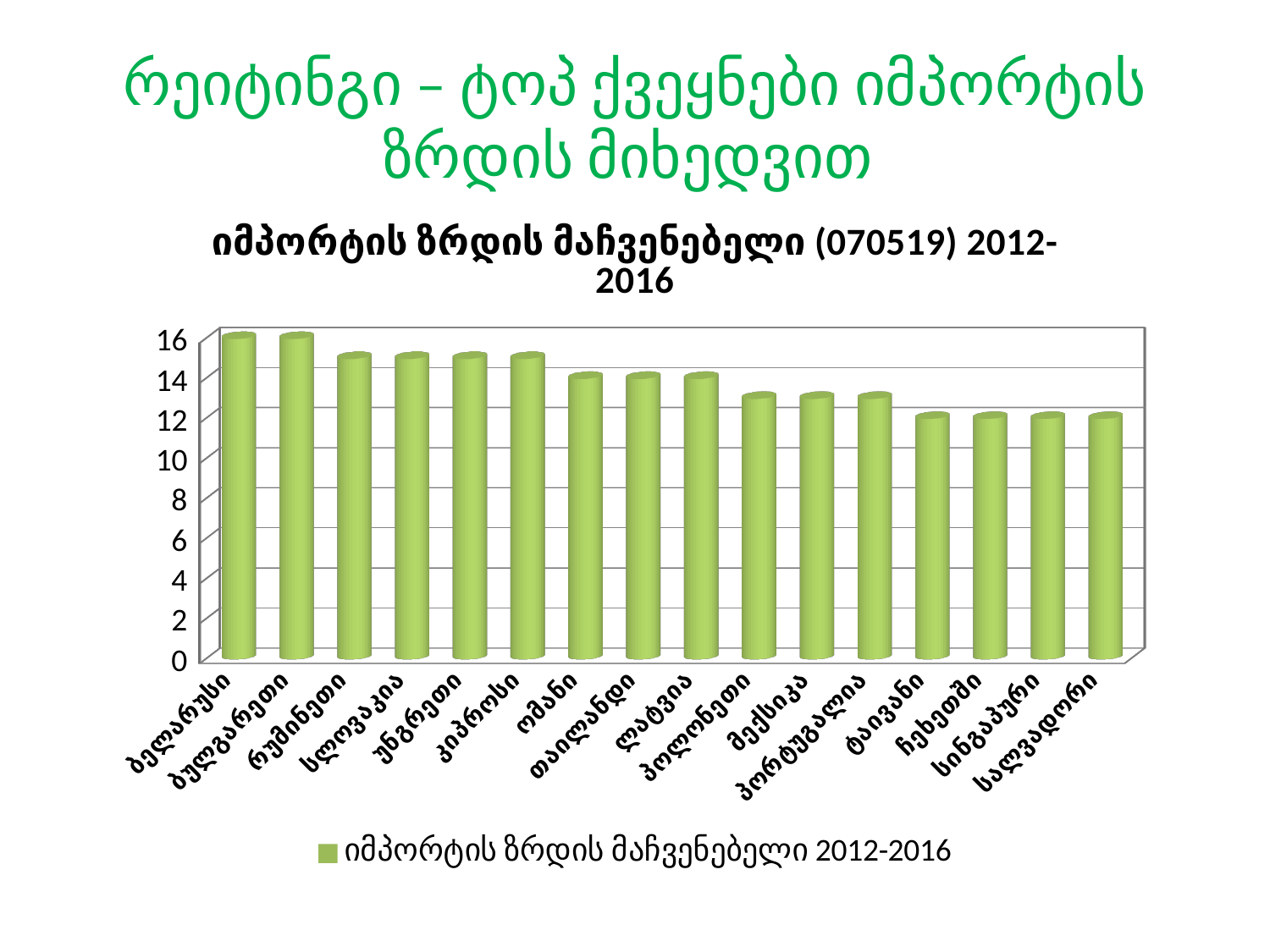
Which has the larger value, ჩეხეთი or უნგრეთი? უნგრეთი What is the legend entry shown below the chart? იმპორტის ზრდის მაჩვენებელი 2012-2016 Is the value for სალვადორი greater or less than 14? less Is the value for პოლონეთი greater or less than 14? less How many series does the chart legend list? 1 Is the value for რუმინეთი greater or less than 14? greater Do the values rise or fall moving from left to right along the x axis? fall What kind of chart is shown on the slide? bar chart Which has the larger value, ბელარუსი or ტაივანი? ბელარუსი How many countries are shown on the x axis of the chart? 16